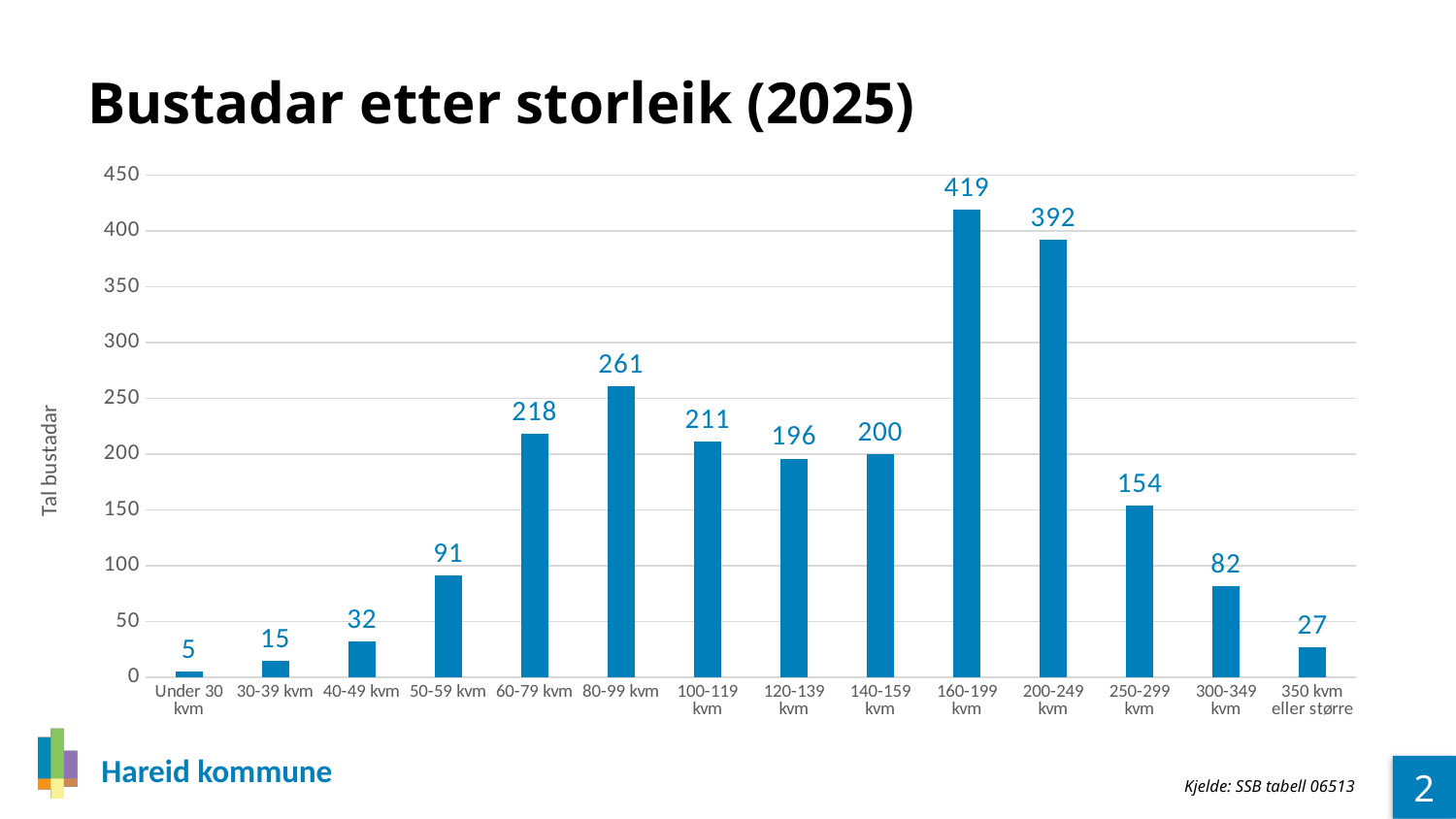
What is the value for 160-199 kvm? 419 What is the label on the y axis? Tal bustadar What is the difference between the values for 160-199 kvm and 200-249 kvm? 27 What is the title of the chart? Bustadar etter storleik (2025) How many categories are shown on the x axis? 14 What is the value for 350 kvm eller større? 27 What is the value for 50-59 kvm? 91 Is the value for 250-299 kvm greater or less than 150? greater What kind of chart is this? bar chart Which is larger, the value for 80-99 kvm or the value for 60-79 kvm? 80-99 kvm Which category has the lowest value? Under 30 kvm Which category has the highest value? 160-199 kvm